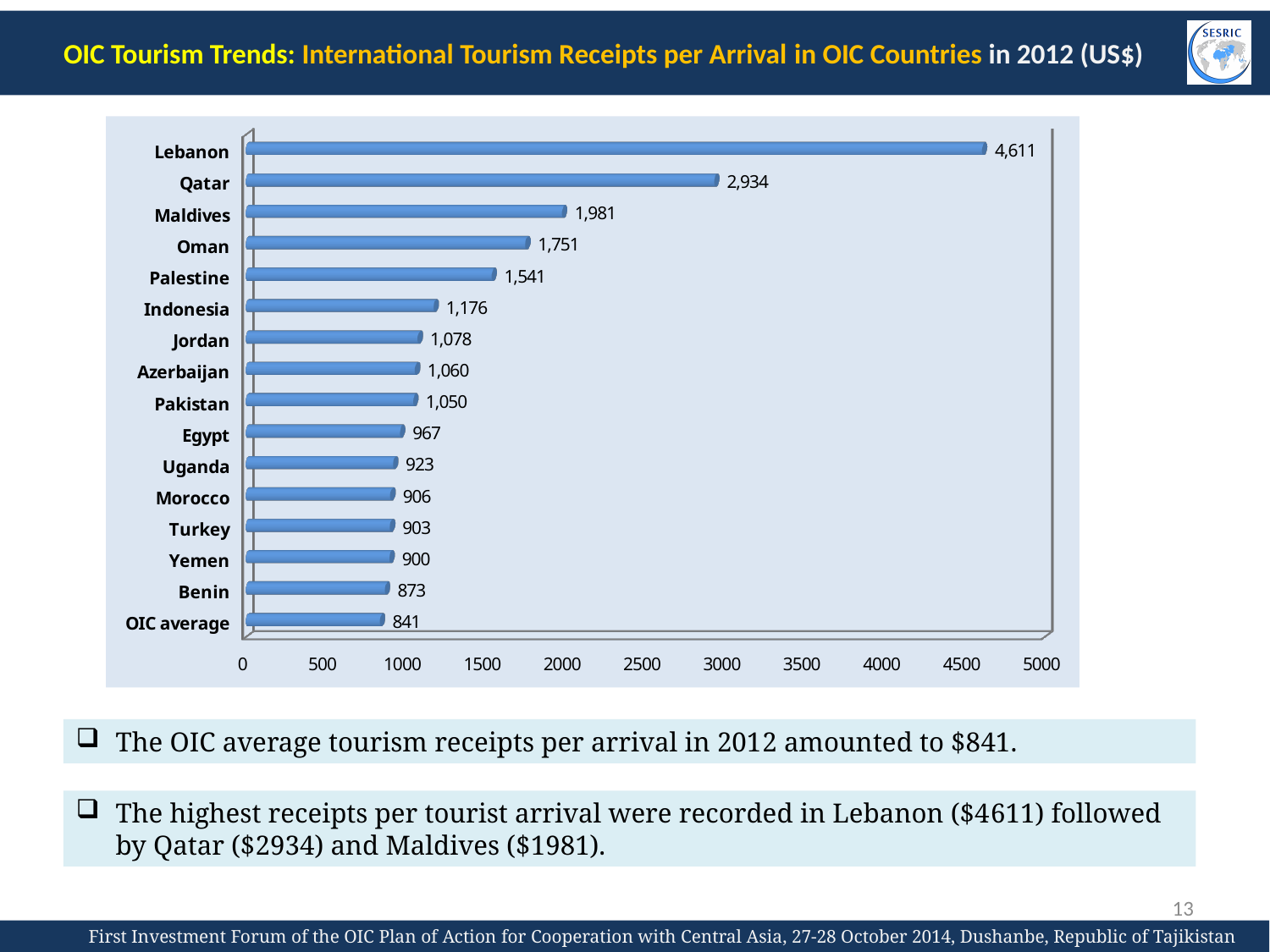
What is the value for Palestine? 1,541 What is the value for Lebanon? 4,611 Which category has the highest value? Lebanon What kind of chart is shown on the slide? bar chart What is the difference between the values for Lebanon and Qatar? 1,677 What is the difference between the values for Maldives and Oman? 230 Which is larger, the value for Indonesia or the value for Jordan? Indonesia Is the value for Qatar greater or less than 3000? less What is the value for the OIC average? 841 Which category has the lowest value? OIC average What is the maximum value shown on the horizontal axis? 5000 How many categories are shown on the chart? 16